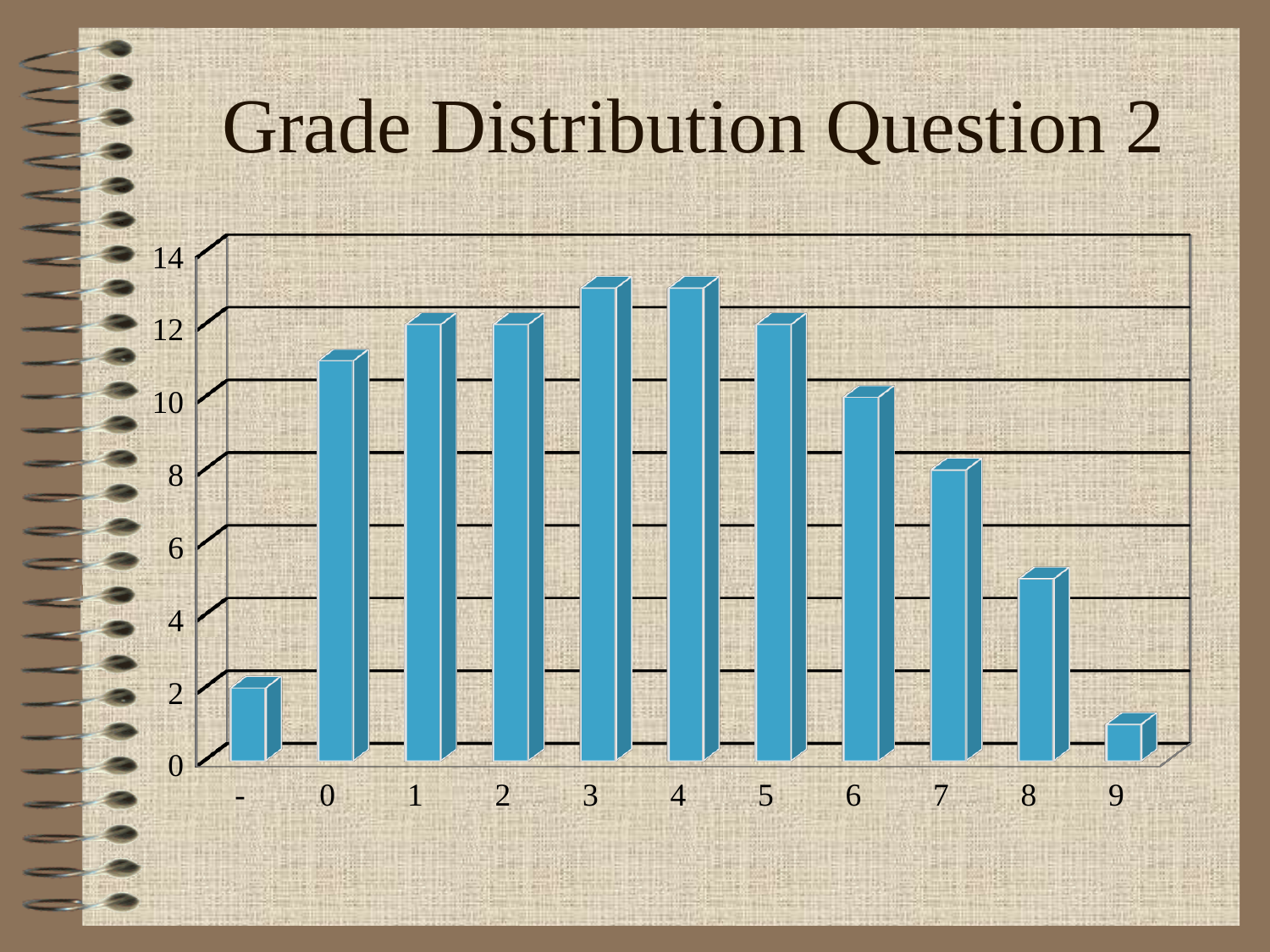
Which has the larger value, category 0 or category 8? 0 What is the title of the chart? Grade Distribution Question 2 What is the value for the category labelled "-"? 2 Which category has the lowest value? 9 Is the value for category 3 greater or less than 12? greater What is the value for category 6? 10 What is the value for category 7? 8 What is the value for category 1? 12 What kind of chart is shown on the slide? bar chart Is the value for category 8 greater or less than 6? less What is the difference between the values for category 1 and category 7? 4 How many categories are shown on the x axis? 11